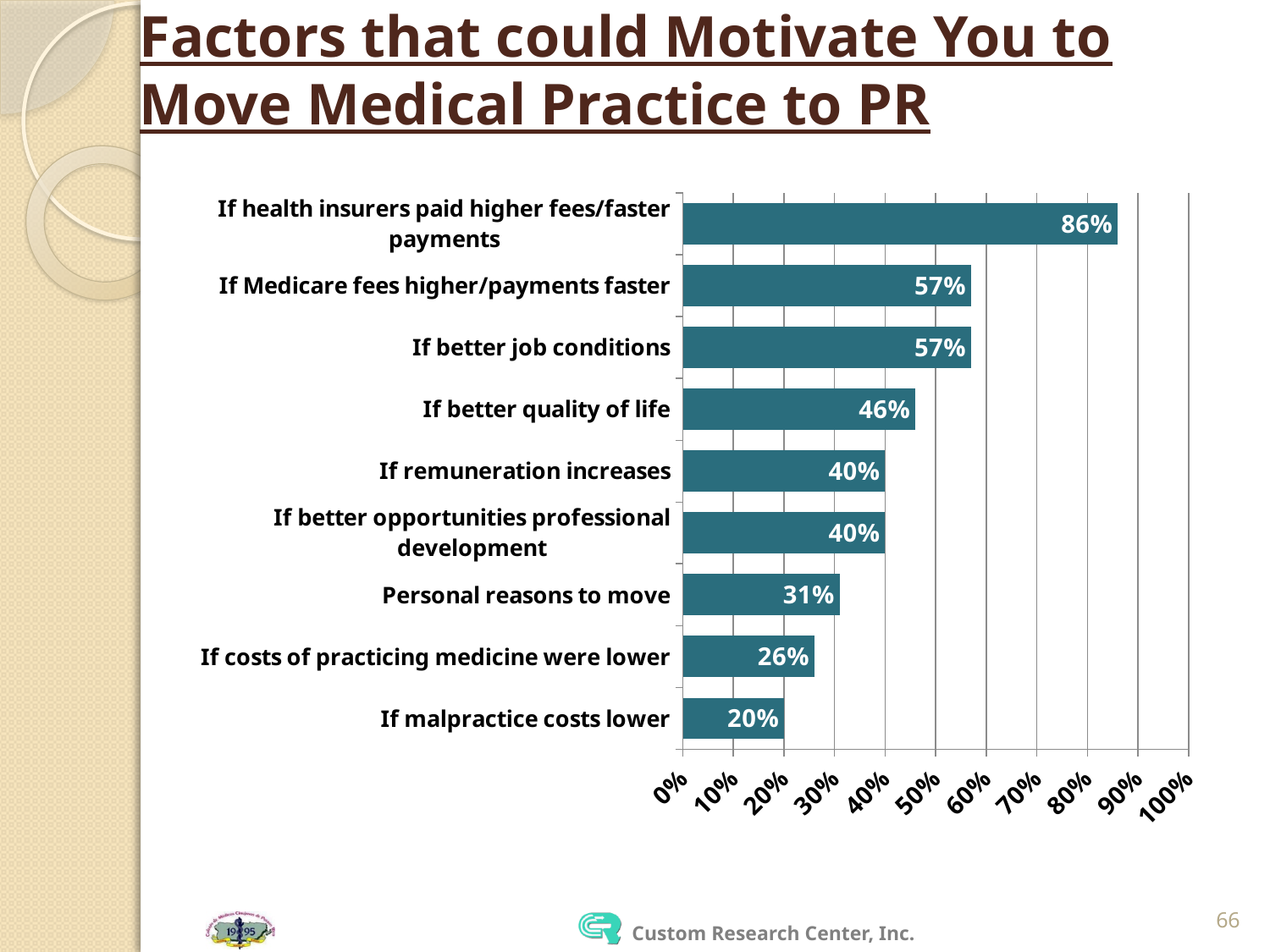
What is the title of the slide? Factors that could Motivate You to Move Medical Practice to PR Which factor has the lowest percentage? If malpractice costs lower Which factor has the highest percentage? If health insurers paid higher fees/faster payments What percentage is shown for 'Personal reasons to move'? 31% What is the value for 'If costs of practicing medicine were lower'? 26% What is the difference between 'If better quality of life' and 'If malpractice costs lower'? 26% What is the value for 'If better quality of life'? 46% What percentage is shown for 'If health insurers paid higher fees/faster payments'? 86% Which is larger, the value for 'If better job conditions' or the value for 'If remuneration increases'? If better job conditions What kind of chart is shown on the slide? Bar chart How many factors (categories) are shown in the chart? 9 What is the difference between the values for 'If health insurers paid higher fees/faster payments' and 'If Medicare fees higher/payments faster'? 29%